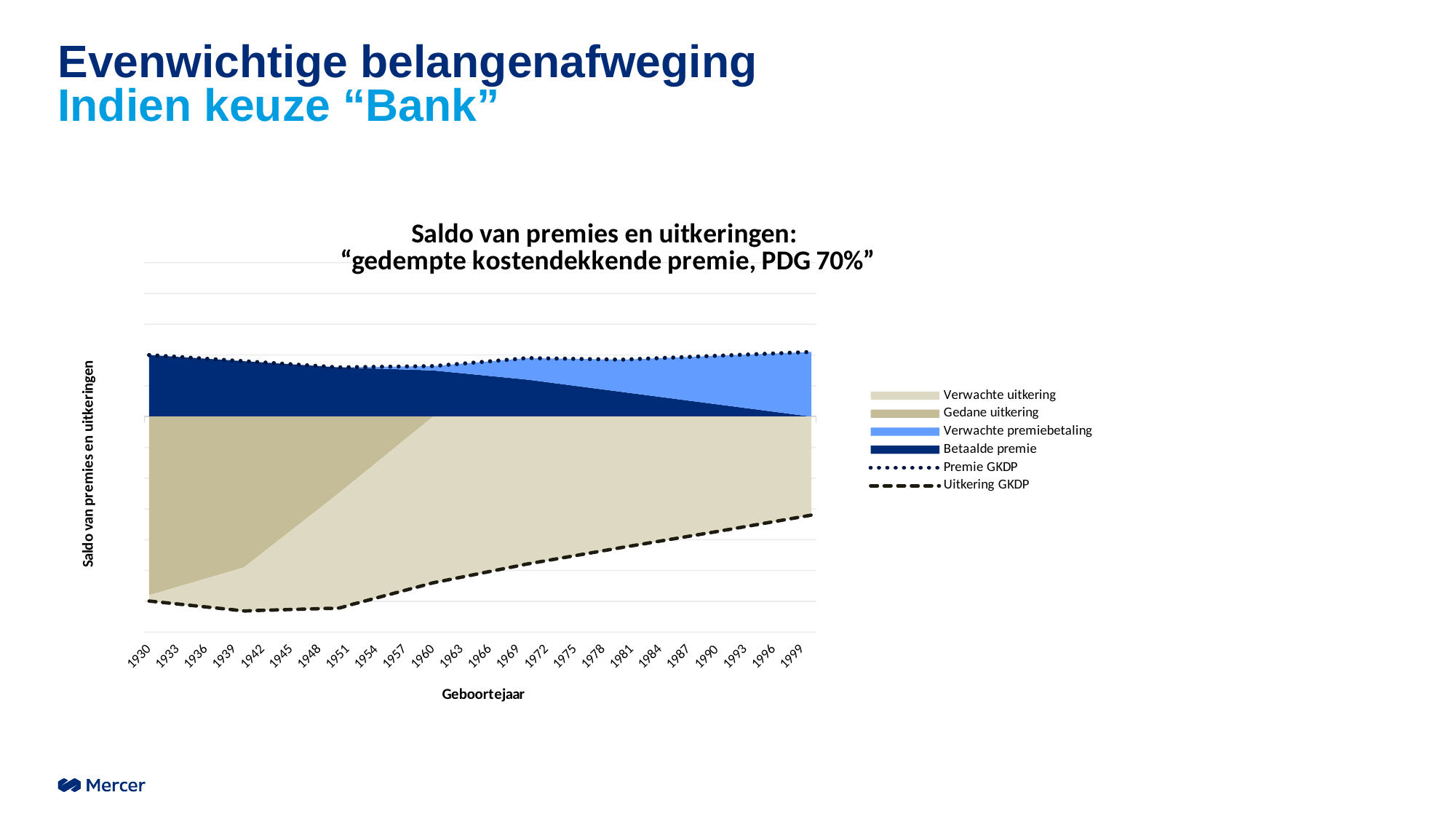
What is the last birth year shown on the x axis? 1999 Does the dashed 'Uitkering GKDP' line rise or fall between birth year 1951 and 1999? Rise Which legend series is drawn as a dotted line? Premie GKDP What is the first birth year shown on the x axis? 1930 What kind of chart is shown on the slide? Combination area and line chart Which legend series is drawn as a dashed line? Uitkering GKDP How many birth-year labels are shown along the x axis? 24 What is the label of the x axis of the chart? Geboortejaar How many series does the chart legend list? 6 Does the 'Uitkering GKDP' line rise or fall between birth year 1930 and 1942? Fall